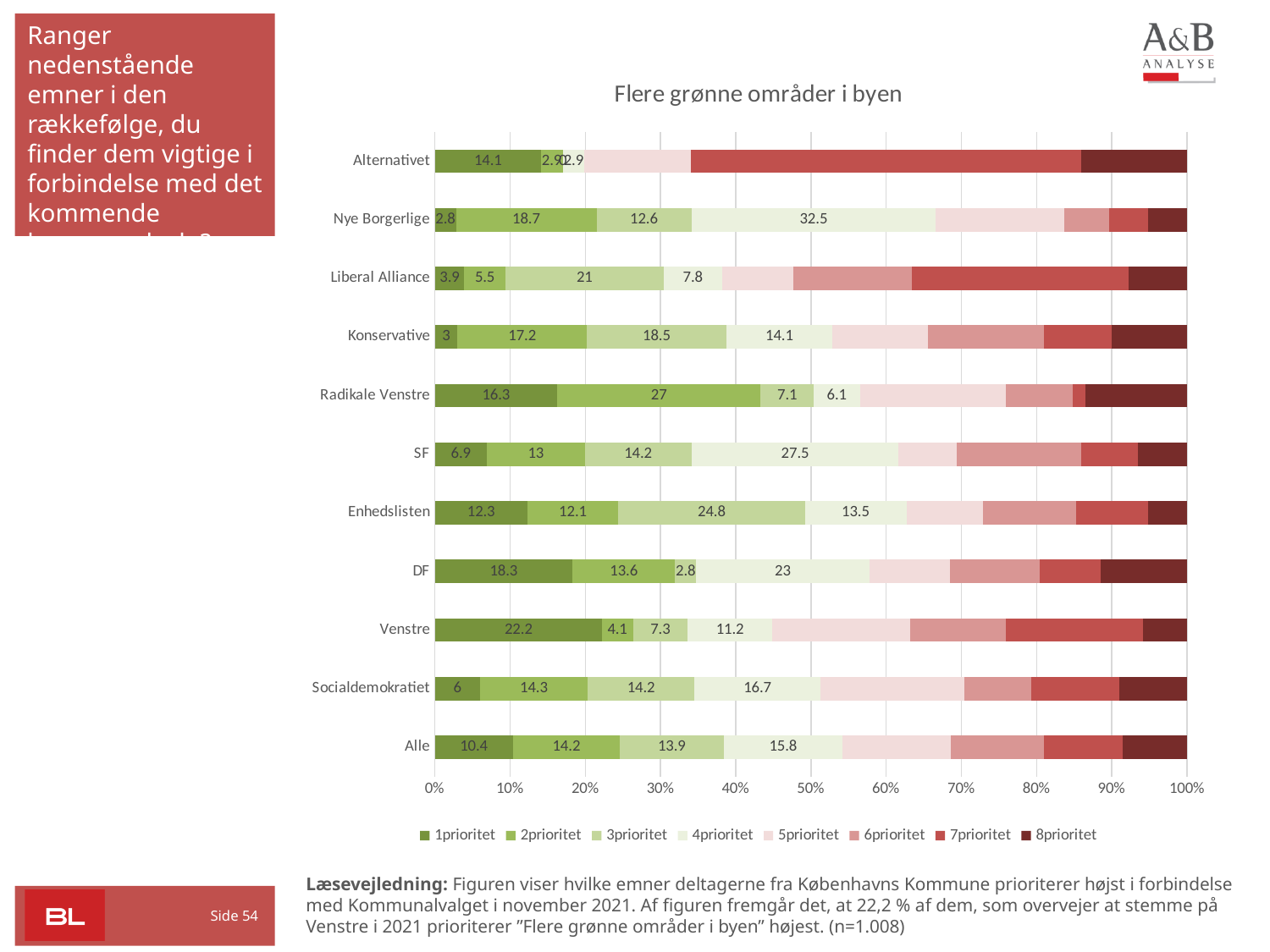
What kind of chart is shown on the slide? Stacked bar chart What is the 2prioritet value for Radikale Venstre? 27 What is the title of the chart? Flere grønne områder i byen Which has a larger 4prioritet value, SF or Enhedslisten? SF What is the 4prioritet value for Nye Borgerlige? 32.5 What is the 3prioritet value for Alle? 13.9 Which category has the lowest 1prioritet value? Nye Borgerlige What is the 1prioritet value for Venstre? 22.2 Which category has the highest 1prioritet value? Venstre How many categories (parties/groups) are shown on the y axis? 11 How many series does the legend list? 8 What is the difference between the 1prioritet values for DF and SF? 11.4